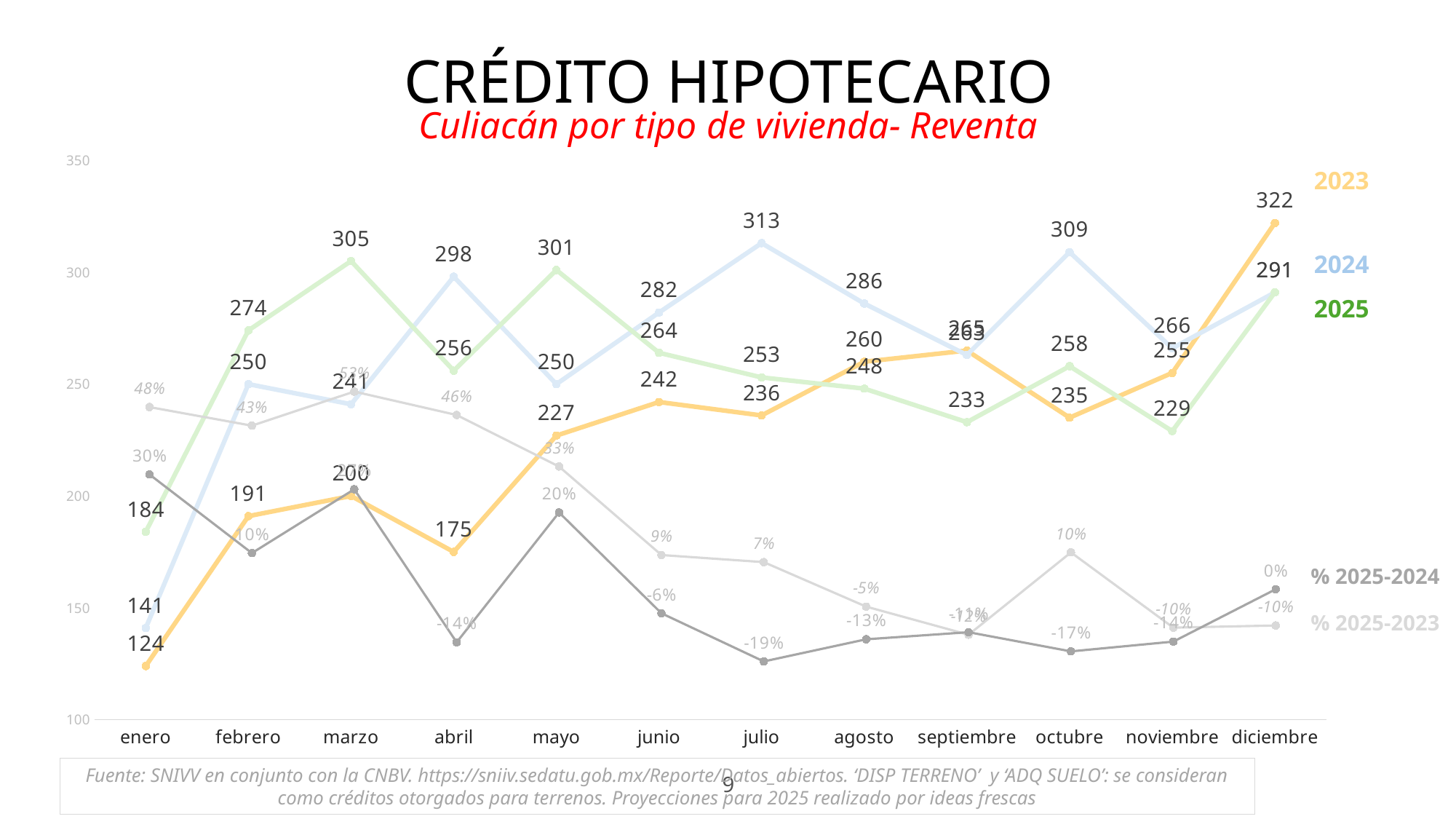
What is the value for 2025 in noviembre? 229 How many months are plotted along the x axis? 12 What is the difference between the 2024 and 2023 values in julio? 77 How many series does the legend list? 5 In which month does the 2023 series reach its highest value? diciembre In which month does the 2024 series have its lowest value? enero What kind of chart is shown on the slide? line chart What is the value for 2025 in marzo? 305 In abril, which series has the larger value, 2024 or 2025? 2024 What is the value for 2023 in enero? 124 What is the % 2025-2024 value in enero? 30% What is the value for 2024 in julio? 313